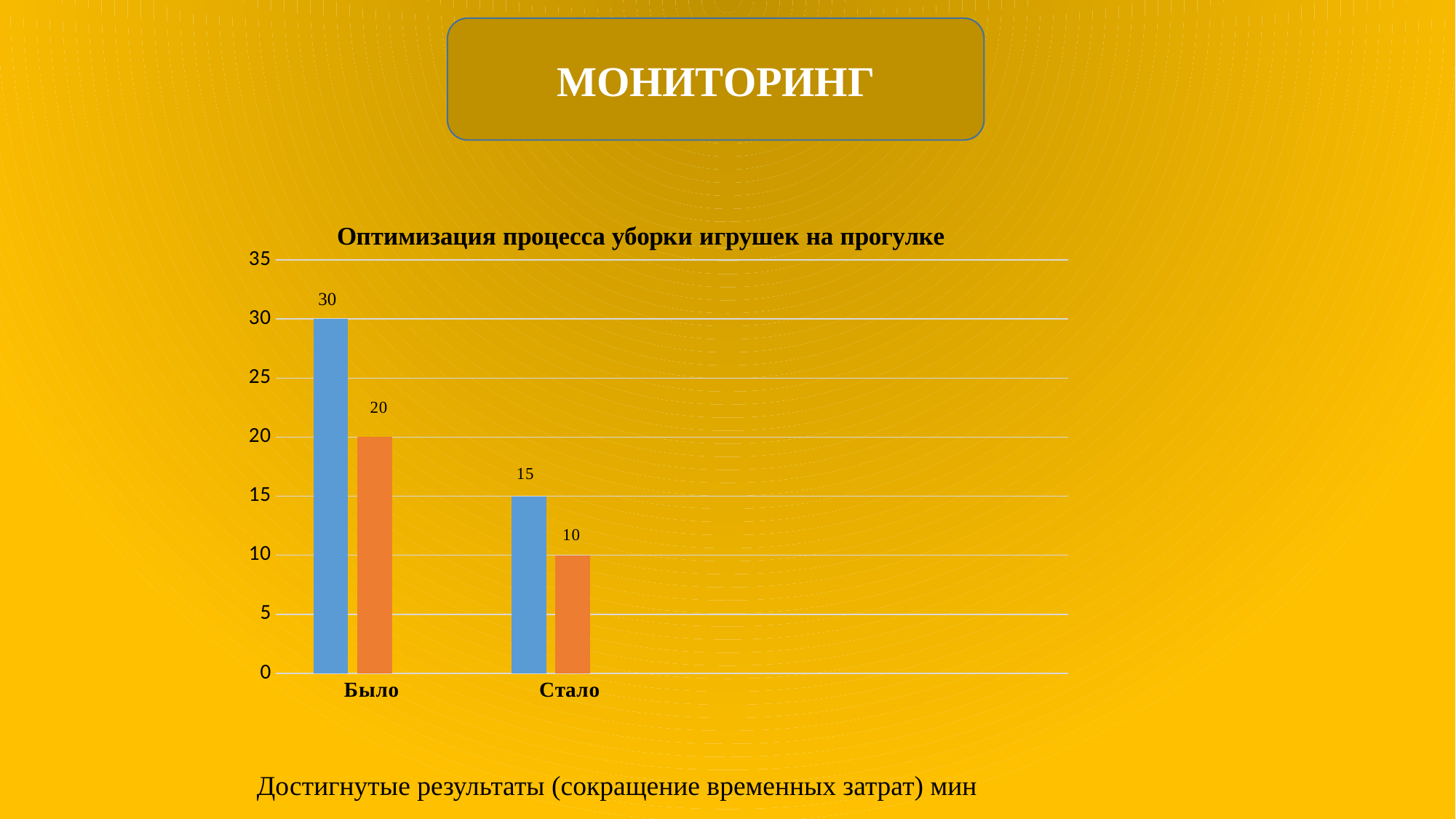
How many categories are shown on the x axis? 2 What is the value of the blue bar for Было? 30 Which is larger: the blue bar for Стало or the orange bar for Было? Orange bar for Было Which bar has the highest value in the chart? Blue bar for Было What type of chart is shown on the slide? Bar chart What is the title of the chart? Оптимизация процесса уборки игрушек на прогулке What is the value of the orange bar for Было? 20 What is the difference between the blue bar values for Было and Стало? 15 Which bar has the lowest value in the chart? Orange bar for Стало What is the value of the blue bar for Стало? 15 What is the difference between the orange bar values for Было and Стало? 10 What is the value of the orange bar for Стало? 10